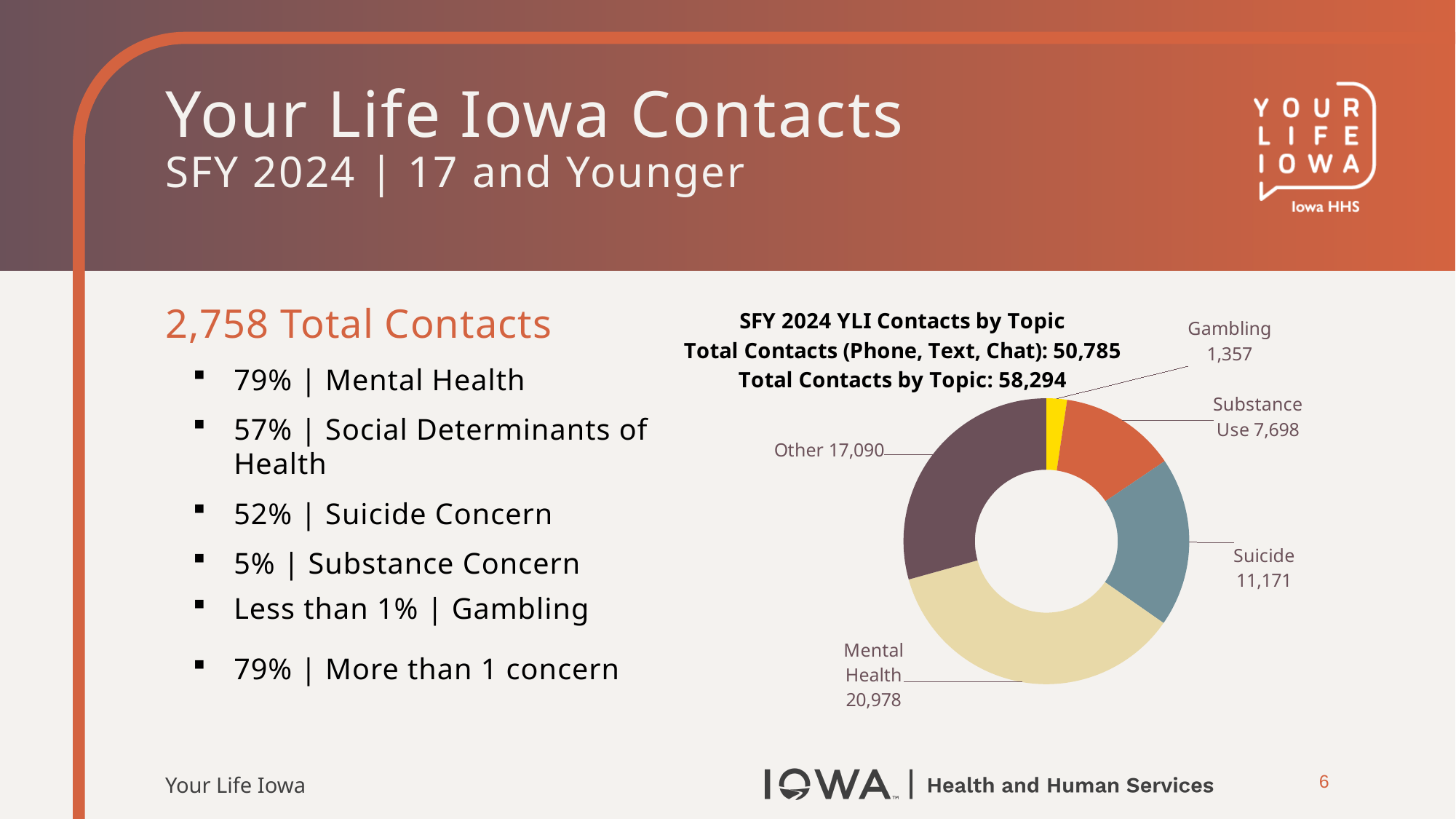
In the SFY 2024 YLI Contacts by Topic chart, how many contacts are shown for Suicide? 11,171 In the SFY 2024 YLI Contacts by Topic chart, how many more contacts does Mental Health have than Other? 3,888 In the SFY 2024 YLI Contacts by Topic chart, which topic has the smallest number of contacts? Gambling What kind of chart is the SFY 2024 YLI Contacts by Topic chart? doughnut chart In the SFY 2024 YLI Contacts by Topic chart, which has more contacts, Other or Suicide? Other In the SFY 2024 YLI Contacts by Topic chart, what is the value for Substance Use? 7,698 How many topic slices does the SFY 2024 YLI Contacts by Topic chart show? 5 In the SFY 2024 YLI Contacts by Topic chart, what is the difference between Suicide and Substance Use contacts? 3,473 In the SFY 2024 YLI Contacts by Topic chart, what is the value for Gambling? 1,357 According to the chart title, what is the total number of contacts by topic? 58,294 In the SFY 2024 YLI Contacts by Topic chart, which topic has the largest number of contacts? Mental Health In the SFY 2024 YLI Contacts by Topic chart, how many contacts are shown for Mental Health? 20,978